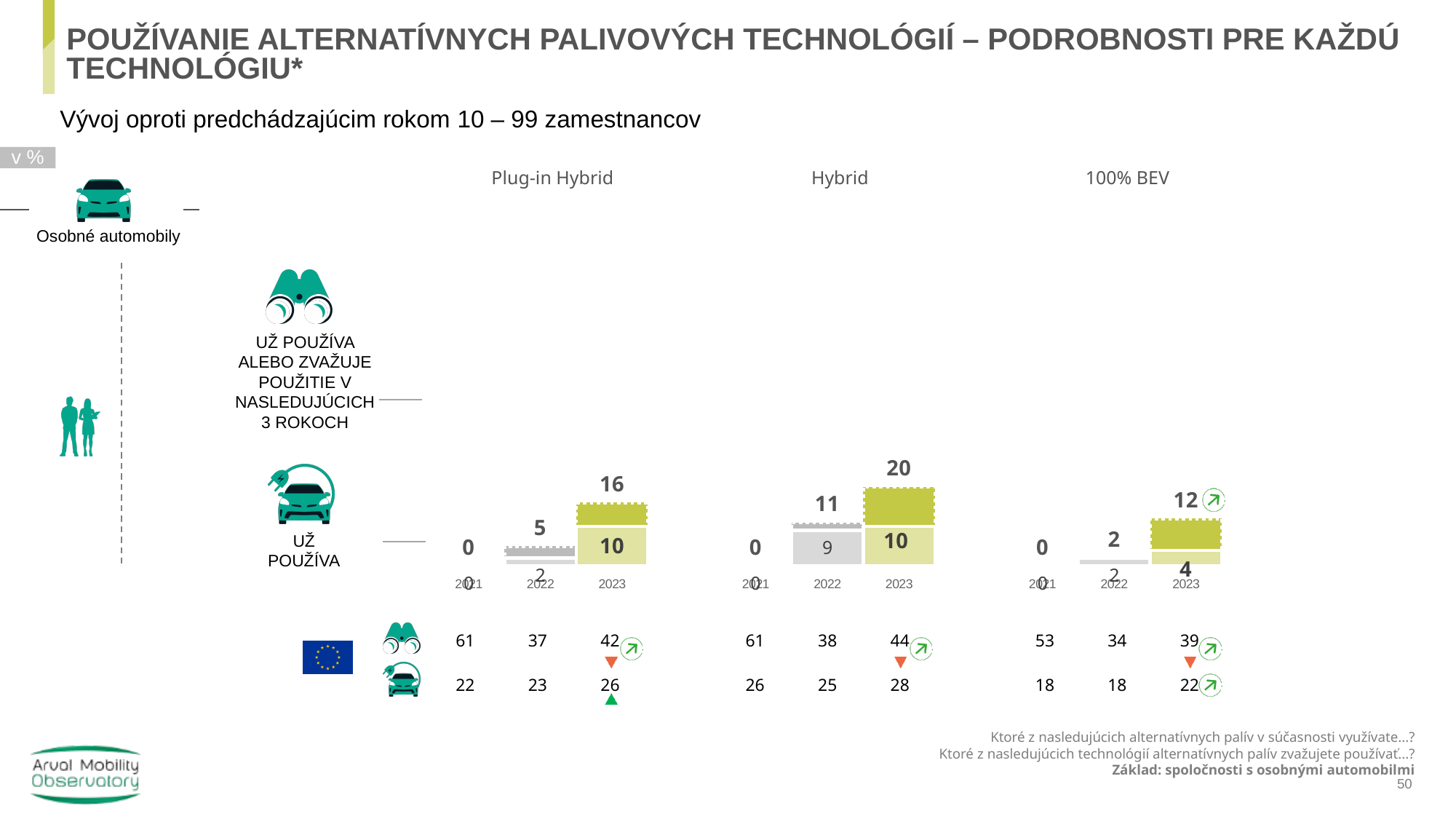
In the Plug-in Hybrid chart, what is the total value shown for 2023? 16 What type of chart is used for the Plug-in Hybrid data? Stacked bar chart How many years are shown on the x axis of the Hybrid chart? 3 In the 100% BEV chart, what is the 'UŽ POUŽÍVA' (already uses) value for 2023? 4 Which is larger: the 2023 total in the Hybrid chart or the 2023 total in the 100% BEV chart? Hybrid In the Hybrid chart, which year has the lowest total value? 2021 In the Plug-in Hybrid chart, which year has the highest total value? 2023 In the Plug-in Hybrid chart, what is the difference between the total values for 2023 and 2022? 11 In the 100% BEV chart, what is the total value shown for 2023? 12 In the 100% BEV chart, do the total values rise or fall from 2021 to 2023? Rise In the Hybrid chart, what is the 'UŽ POUŽÍVA' (already uses) value for 2022? 9 In the Hybrid chart, what is the total value shown for 2023? 20